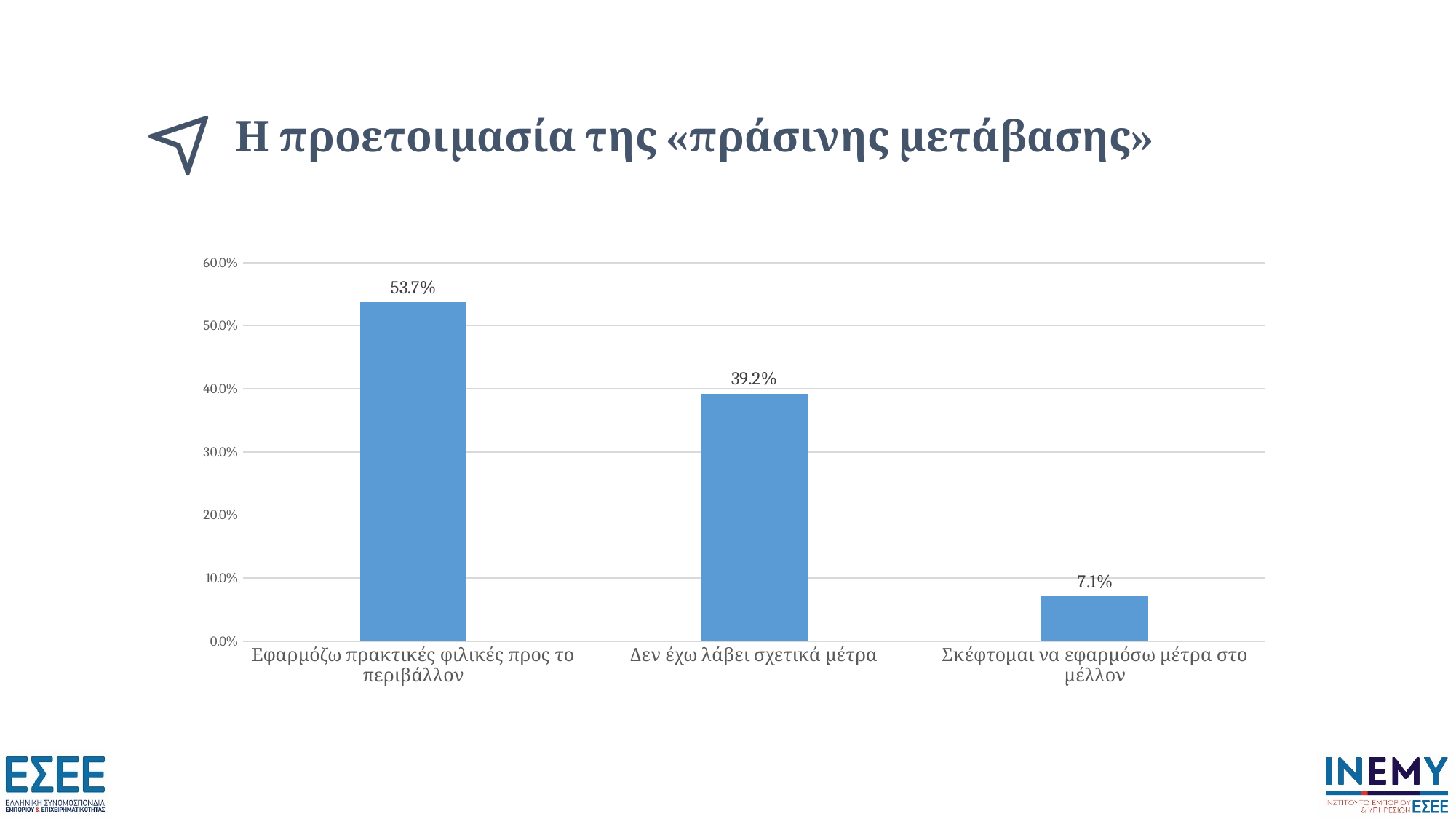
What is the title of the slide? Η προετοιμασία της «πράσινης μετάβασης» Which category has the lowest value? Σκέφτομαι να εφαρμόσω μέτρα στο μέλλον What is the difference between «Δεν έχω λάβει σχετικά μέτρα» and «Σκέφτομαι να εφαρμόσω μέτρα στο μέλλον»? 32.1% Which is larger: «Δεν έχω λάβει σχετικά μέτρα» or «Σκέφτομαι να εφαρμόσω μέτρα στο μέλλον»? Δεν έχω λάβει σχετικά μέτρα What is the value for «Εφαρμόζω πρακτικές φιλικές προς το περιβάλλον»? 53.7% What kind of chart is shown on the slide? Bar chart What is the value for «Δεν έχω λάβει σχετικά μέτρα»? 39.2% Is the value for «Δεν έχω λάβει σχετικά μέτρα» greater or less than 40.0%? less How many categories are shown in the chart? 3 Which category has the highest value? Εφαρμόζω πρακτικές φιλικές προς το περιβάλλον What is the value for «Σκέφτομαι να εφαρμόσω μέτρα στο μέλλον»? 7.1% What is the difference between «Εφαρμόζω πρακτικές φιλικές προς το περιβάλλον» and «Δεν έχω λάβει σχετικά μέτρα»? 14.5%